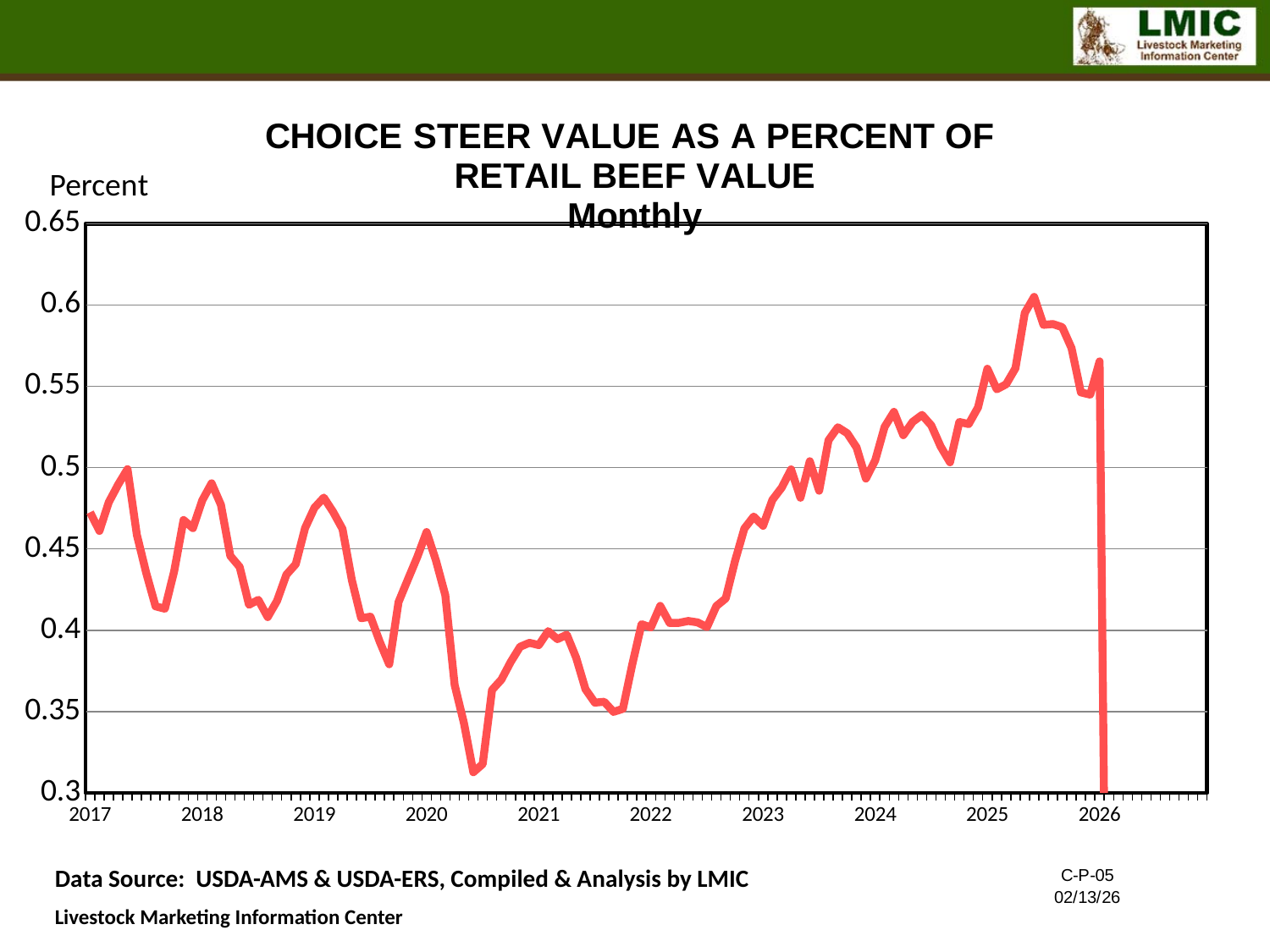
Does the line generally rise or fall between 2021 and 2025? rise Is the lowest value on the chart, reached in 2020, greater or less than 0.35? less Is the value at the start of 2017 greater or less than 0.45? greater What label is shown on the vertical axis of the chart? Percent Is the peak value reached in 2025 greater or less than 0.55? greater Does the line generally rise or fall between 2017 and mid-2020? fall In which year does the line reach its lowest point? 2020 What is the title of the chart? CHOICE STEER VALUE AS A PERCENT OF RETAIL BEEF VALUE Monthly What kind of chart is shown on the slide? line chart In which year does the line reach its highest point? 2025 How many lines (data series) are plotted on the chart? 1